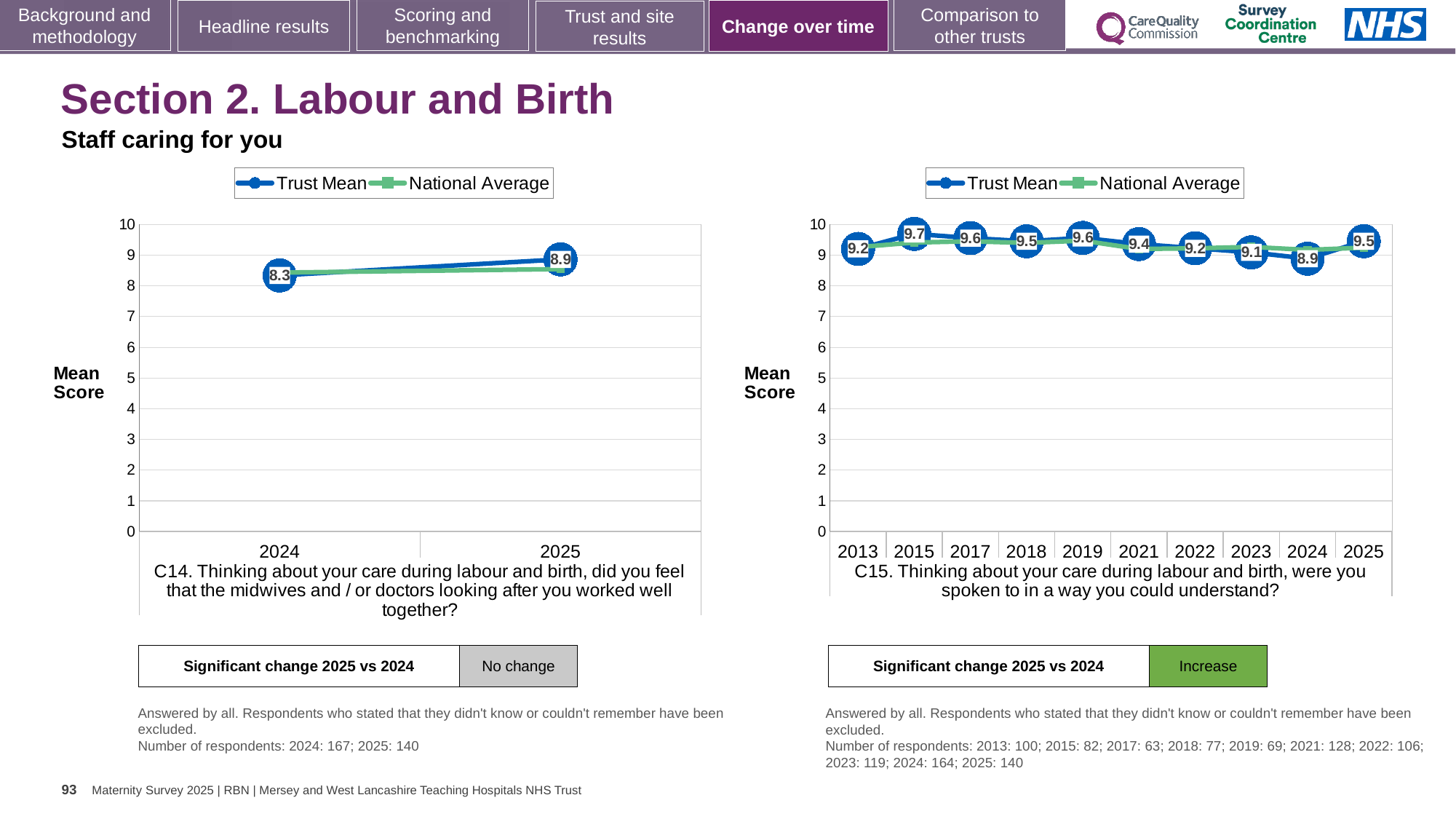
On the C14 chart (left), by how much did the Trust Mean change from 2024 to 2025? 0.6 On the C15 chart (right), which year has the lowest Trust Mean? 2024 On the C15 chart (right), how many series does the legend list? 2 On the C14 chart (left), what is the Trust Mean for 2024? 8.3 On the C15 chart (right), what is the difference between the Trust Mean in 2025 and in 2024? 0.6 On the C14 chart (left), what is the Trust Mean for 2025? 8.9 What type of chart is the C14 chart on the left? line chart On the C15 chart (right), what is the Trust Mean for 2015? 9.7 On the C15 chart (right), which year has the highest Trust Mean? 2015 On the C15 chart (right), how many years are shown on the x axis? 10 On the C14 chart (left), does the Trust Mean rise or fall from 2024 to 2025? rise On the C15 chart (right), what is the Trust Mean for 2024? 8.9